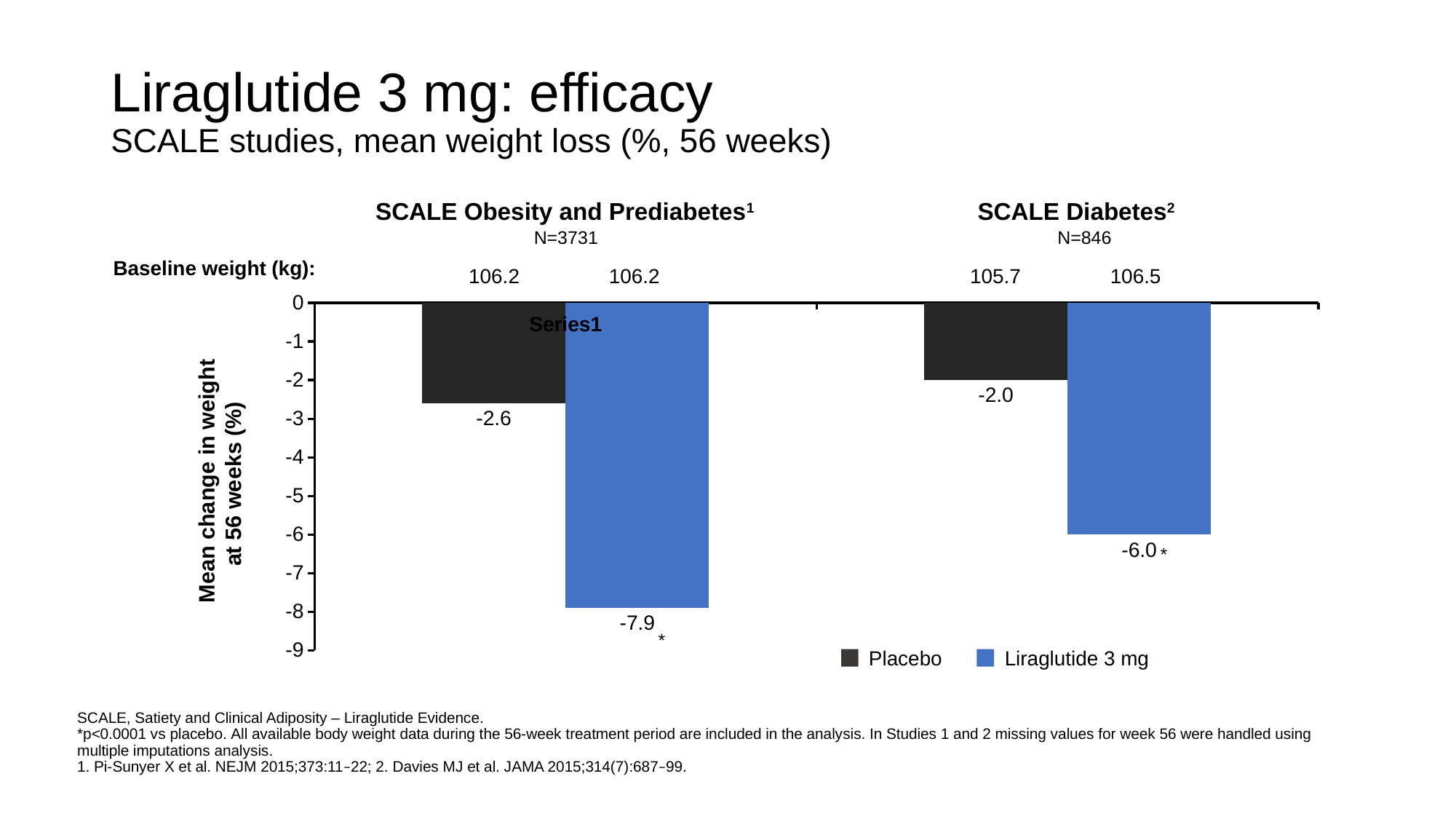
What is the mean change in weight at 56 weeks for Liraglutide 3 mg in the SCALE Diabetes study? -6.0 What is the mean change in weight at 56 weeks for Liraglutide 3 mg in the SCALE Obesity and Prediabetes study? -7.9 Which bar shows the largest weight loss (most negative value) on the chart? Liraglutide 3 mg in SCALE Obesity and Prediabetes What kind of chart is shown on the slide? Bar chart What is the difference between the Liraglutide 3 mg and Placebo values in the SCALE Obesity and Prediabetes study? 5.3 Which shows a greater weight loss: Liraglutide 3 mg in SCALE Diabetes or Placebo in SCALE Obesity and Prediabetes? Liraglutide 3 mg in SCALE Diabetes Which bar shows the smallest weight loss (least negative value) on the chart? Placebo in SCALE Diabetes What is the baseline weight (kg) shown for the Placebo group in the SCALE Diabetes study? 105.7 What is the mean change in weight at 56 weeks for Placebo in the SCALE Obesity and Prediabetes study? -2.6 What is the mean change in weight at 56 weeks for Placebo in the SCALE Diabetes study? -2.0 How many series does the legend list? 2 What is the difference between the Liraglutide 3 mg and Placebo values in the SCALE Diabetes study? 4.0